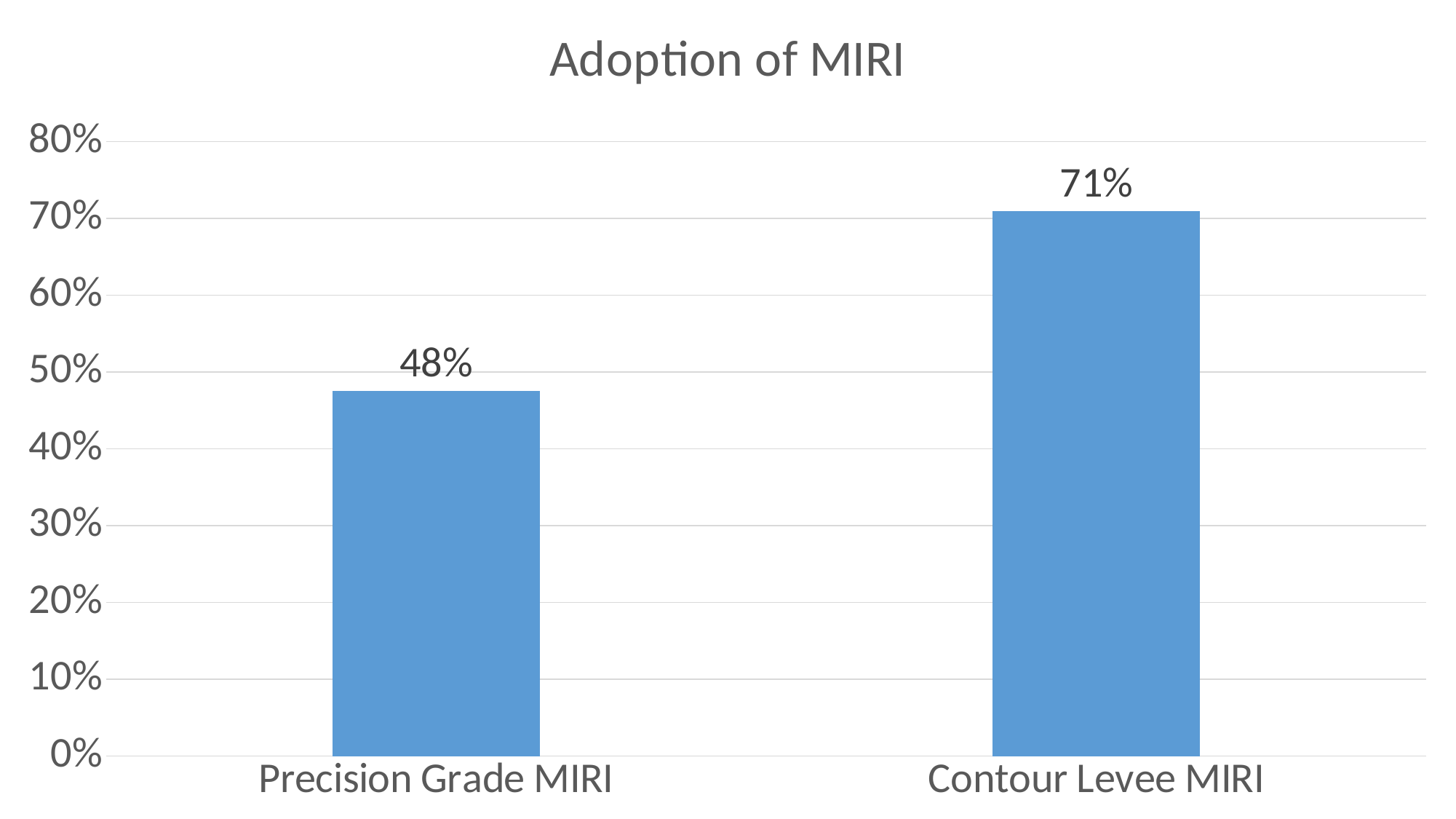
What is the maximum value shown on the vertical axis? 80% Which category has the highest adoption? Contour Levee MIRI Is the value for Contour Levee MIRI greater or less than 60%? greater Is the value for Precision Grade MIRI greater or less than 50%? less Which is larger, the adoption of Precision Grade MIRI or Contour Levee MIRI? Contour Levee MIRI What kind of chart is shown on the slide? Bar chart What is the title of the chart? Adoption of MIRI How many categories are shown in the chart? 2 What is the adoption value for Contour Levee MIRI? 71% What is the difference in adoption between Contour Levee MIRI and Precision Grade MIRI? 23% What is the adoption value for Precision Grade MIRI? 48% Which category has the lowest adoption? Precision Grade MIRI